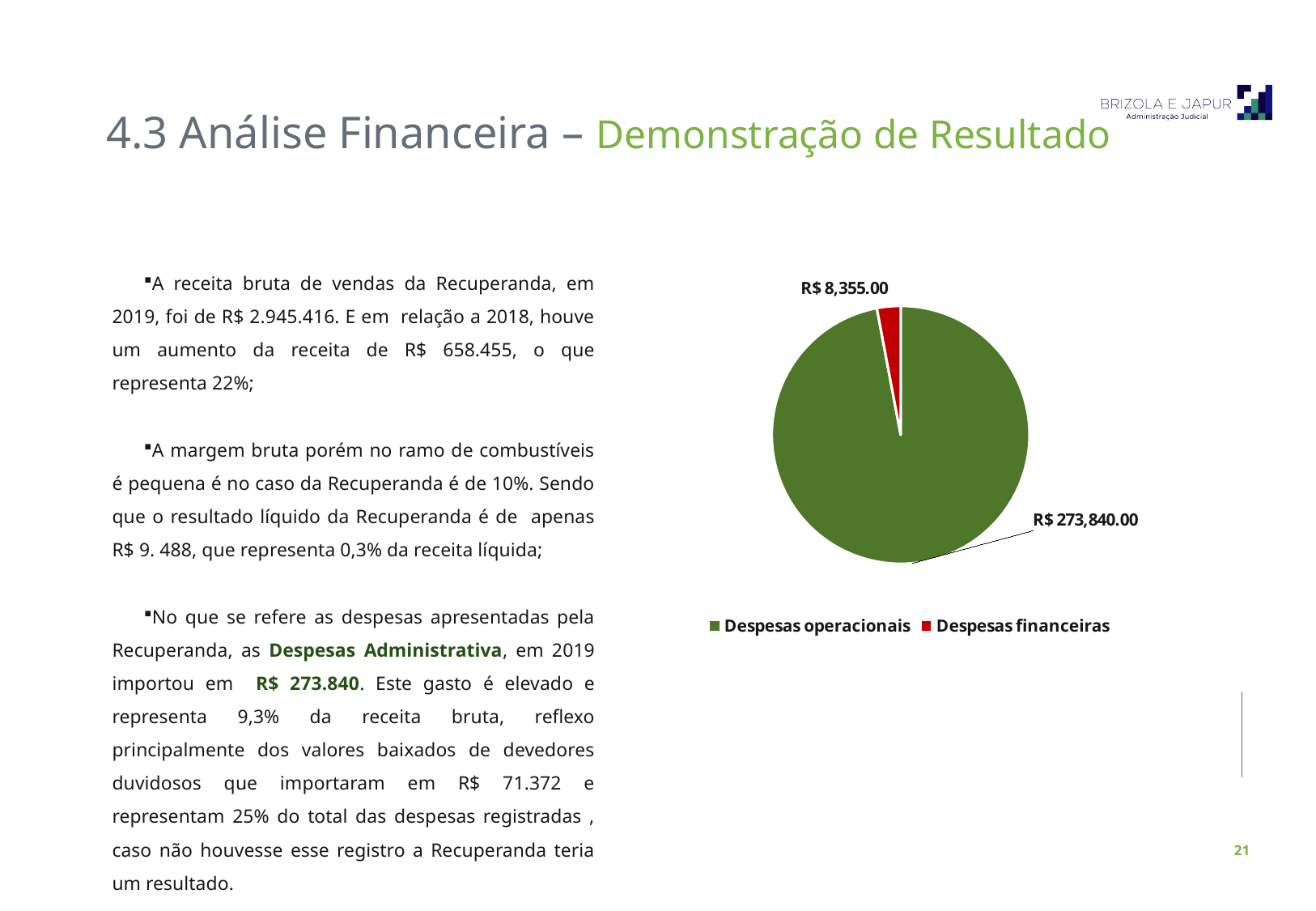
What is the value of the Despesas financeiras slice in the pie chart? R$ 8,355.00 What colour is the Despesas operacionais slice in the pie chart? Green Which category has the largest slice in the pie chart? Despesas operacionais How many entries does the legend of the pie chart list? 2 What kind of chart is shown on the slide? Pie chart What is the total of the two slices in the pie chart? R$ 282,195.00 How many slices does the pie chart have? 2 Which category has the smallest slice in the pie chart? Despesas financeiras Which is larger in the pie chart, Despesas operacionais or Despesas financeiras? Despesas operacionais What is the value of the Despesas operacionais slice in the pie chart? R$ 273,840.00 What is the difference between Despesas operacionais and Despesas financeiras in the pie chart? R$ 265,485.00 What colour is the Despesas financeiras slice in the pie chart? Red